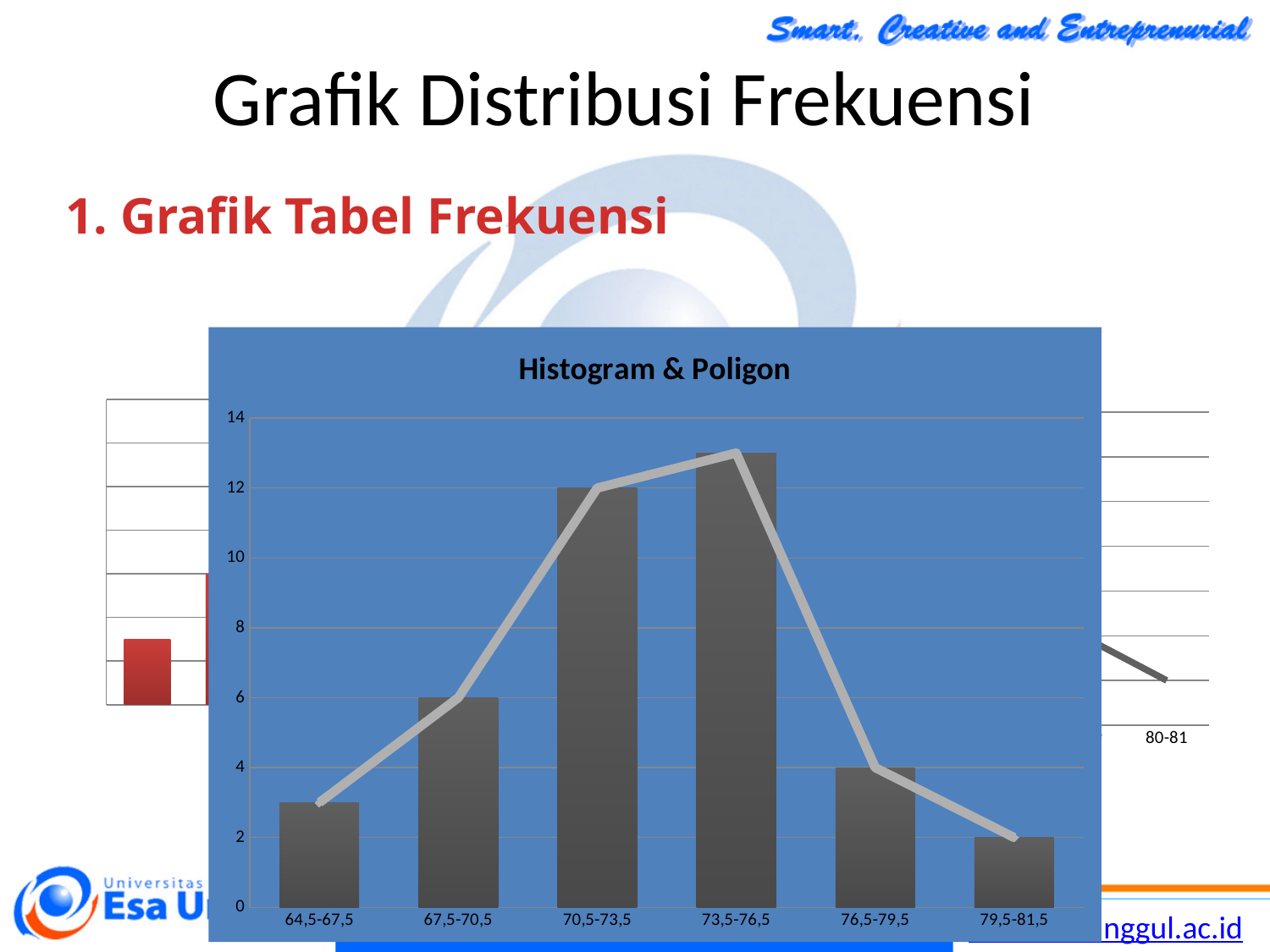
How many class intervals are shown on the x axis of the Histogram & Poligon chart? 6 In the Histogram & Poligon chart, what is the value for the 79,5-81,5 class? 2 In the Histogram & Poligon chart, which class has the lowest bar? 79,5-81,5 In the Histogram & Poligon chart, what is the value for the 67,5-70,5 class? 6 In the Histogram & Poligon chart, which is larger, the value for 70,5-73,5 or the value for 76,5-79,5? 70,5-73,5 In the Histogram & Poligon chart, what is the value for the 70,5-73,5 class? 12 In the Histogram & Poligon chart, which class has the highest bar? 73,5-76,5 In the Histogram & Poligon chart, is the value for 64,5-67,5 greater or less than 4? less In the Histogram & Poligon chart, is the value for 73,5-76,5 greater or less than 12? greater In the Histogram & Poligon chart, what is the value for the 76,5-79,5 class? 4 What is the title of the large chart in the centre of the slide? Histogram & Poligon In the Histogram & Poligon chart, what is the difference between the values for 70,5-73,5 and 67,5-70,5? 6